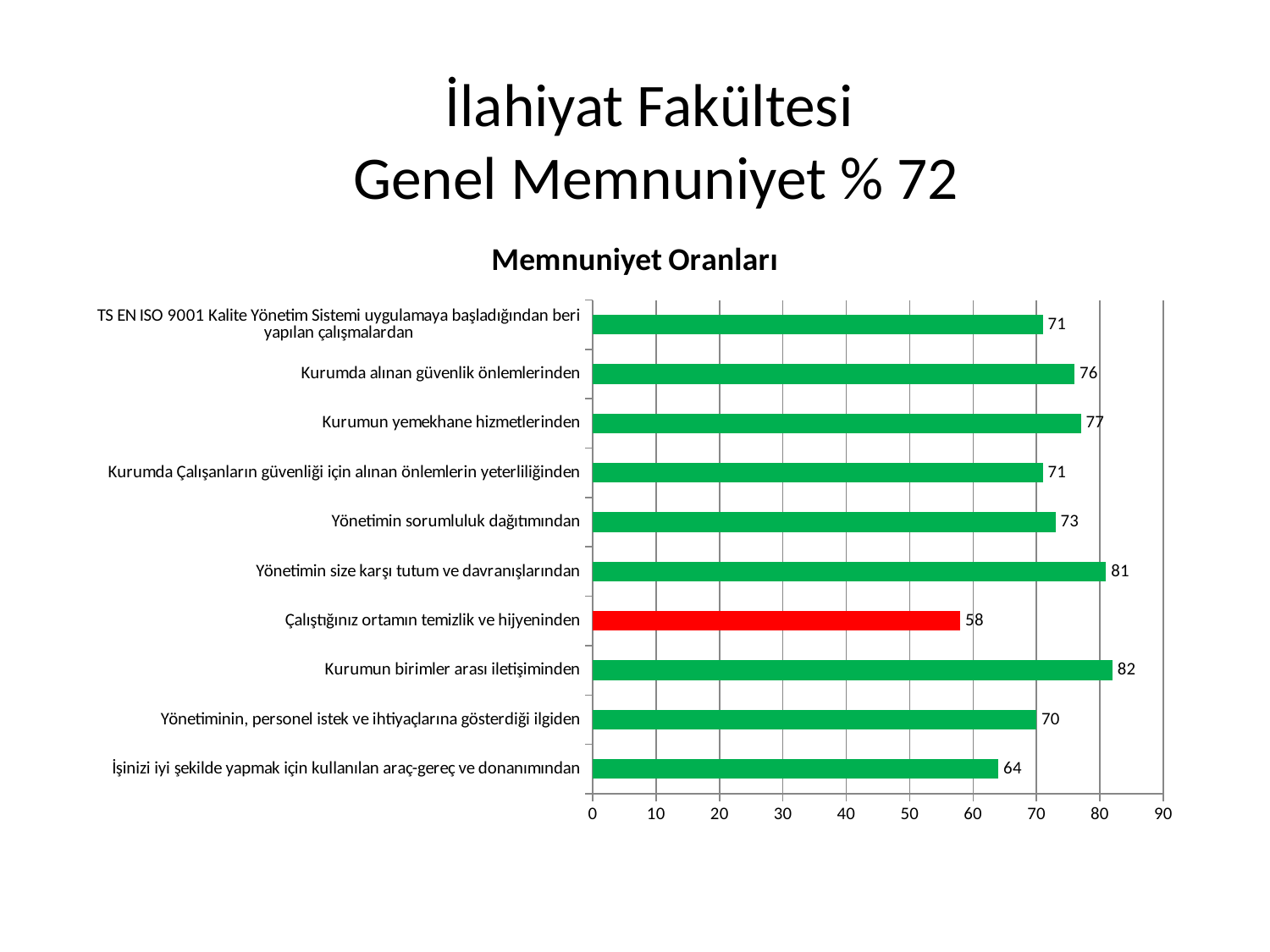
What kind of chart is shown on the slide? bar chart Which category has the lowest value? Çalıştığınız ortamın temizlik ve hijyeninden Is the value for "Yönetimin size karşı tutum ve davranışlarından" greater or less than 80? greater How many categories are shown in the chart? 10 What is the value for "Kurumun yemekhane hizmetlerinden"? 77 Which category's bar is coloured red? Çalıştığınız ortamın temizlik ve hijyeninden Which is larger: the value for "Kurumda alınan güvenlik önlemlerinden" or the value for "İşinizi iyi şekilde yapmak için kullanılan araç-gereç ve donanımından"? Kurumda alınan güvenlik önlemlerinden What is the difference between the values for "Kurumun birimler arası iletişiminden" and "Çalıştığınız ortamın temizlik ve hijyeninden"? 24 What is the value for "Çalıştığınız ortamın temizlik ve hijyeninden"? 58 Which category has the highest value? Kurumun birimler arası iletişiminden What is the value for "Yönetiminin, personel istek ve ihtiyaçlarına gösterdiği ilgiden"? 70 What is the title of the chart? Memnuniyet Oranları